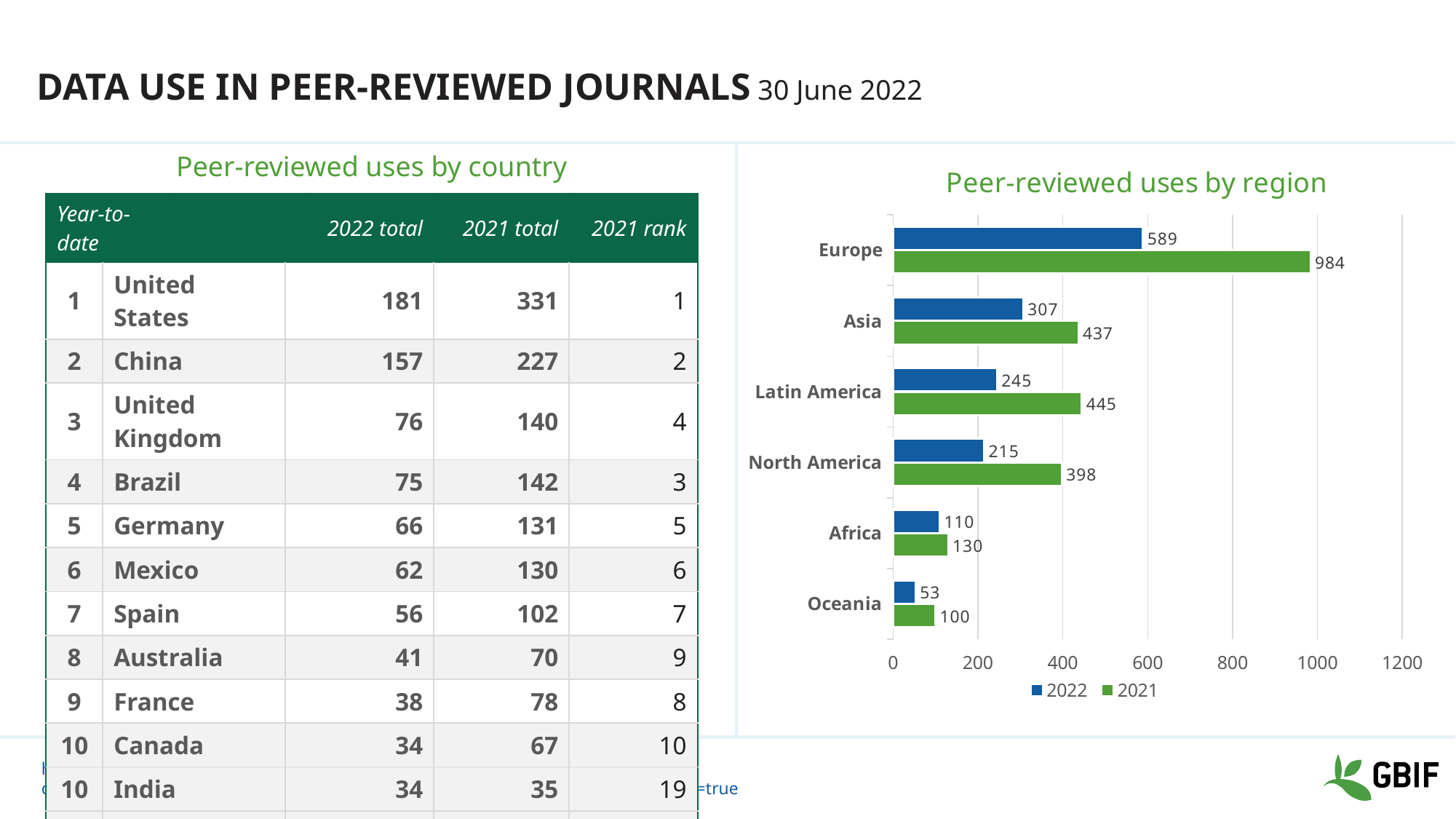
In the 'Peer-reviewed uses by region' chart, is the 2022 value for North America greater or less than 200? greater In the 'Peer-reviewed uses by region' chart, what is the 2021 value for North America? 398 In the 'Peer-reviewed uses by region' chart, what is the difference between the 2021 and 2022 values for Europe? 395 How many regions are shown in the 'Peer-reviewed uses by region' chart? 6 In the 'Peer-reviewed uses by region' chart, which region has the highest 2022 value? Europe In the 'Peer-reviewed uses by region' chart, which region has the lowest 2021 value? Oceania In the 'Peer-reviewed uses by region' chart, what is the difference between the 2022 values for Asia and Africa? 197 In the 'Peer-reviewed uses by region' chart, what is the 2021 value for Europe? 984 What type of chart is 'Peer-reviewed uses by region'? Bar chart How many series does the legend of the 'Peer-reviewed uses by region' chart list? 2 In the 'Peer-reviewed uses by region' chart, what is the 2022 value for Latin America? 245 In the 'Peer-reviewed uses by region' chart, which is larger: the 2021 value for Asia or the 2021 value for Latin America? Latin America